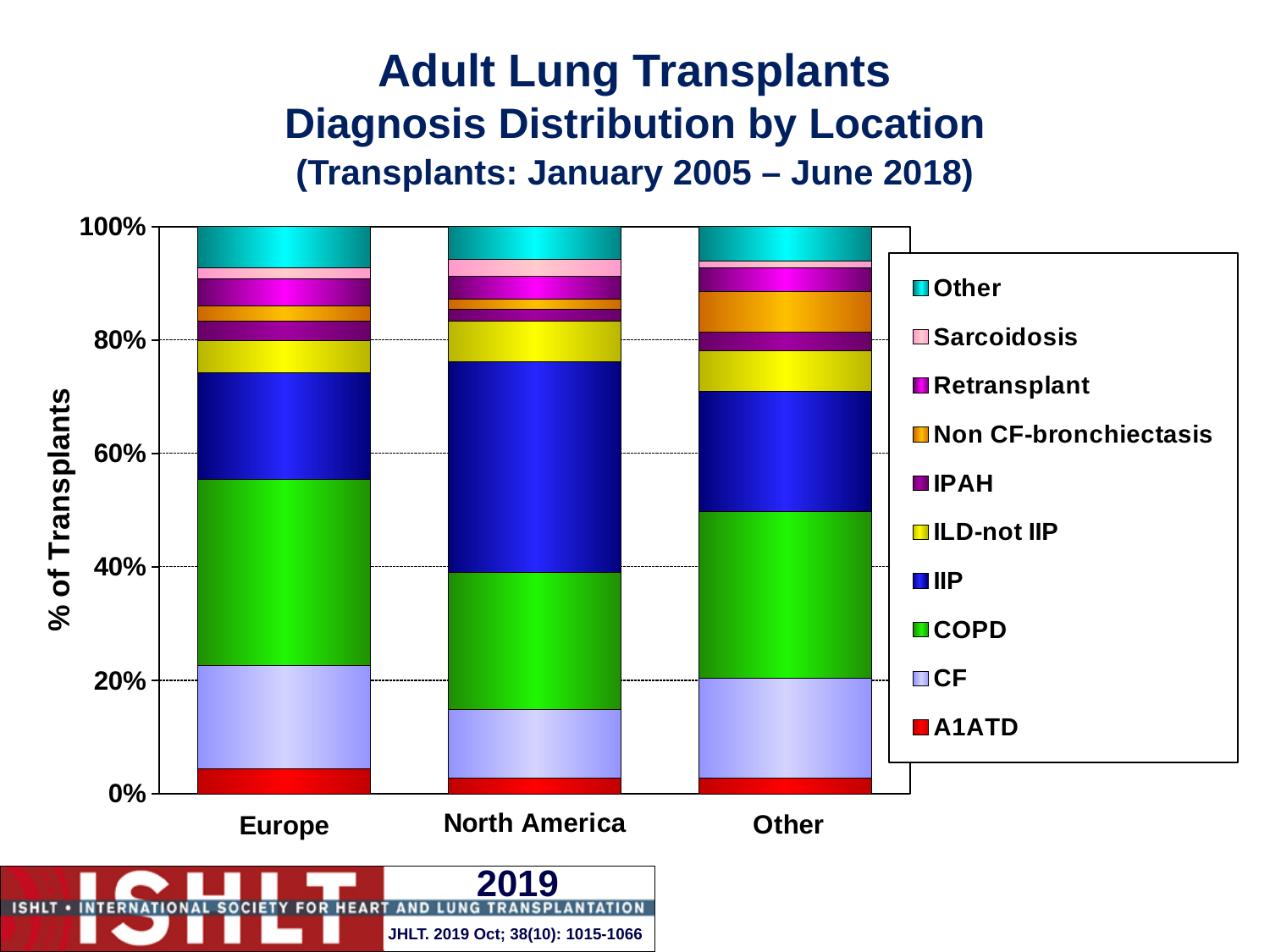
Which location has the smallest CF segment? North America Is the IIP segment larger for North America or for Europe? North America Is the A1ATD share for Europe greater or less than 20%? less Which location has the largest IIP segment? North America Is the COPD segment larger for Europe or for North America? Europe What transplant date range is given in the chart title? January 2005 – June 2018 What does each stacked bar total? 100% How many locations (bars) are shown on the x axis? 3 How many diagnosis categories does the legend list? 10 Is the COPD share for North America greater or less than 20%? greater What is the label of the y axis? % of Transplants What kind of chart is shown on the slide? Stacked bar chart